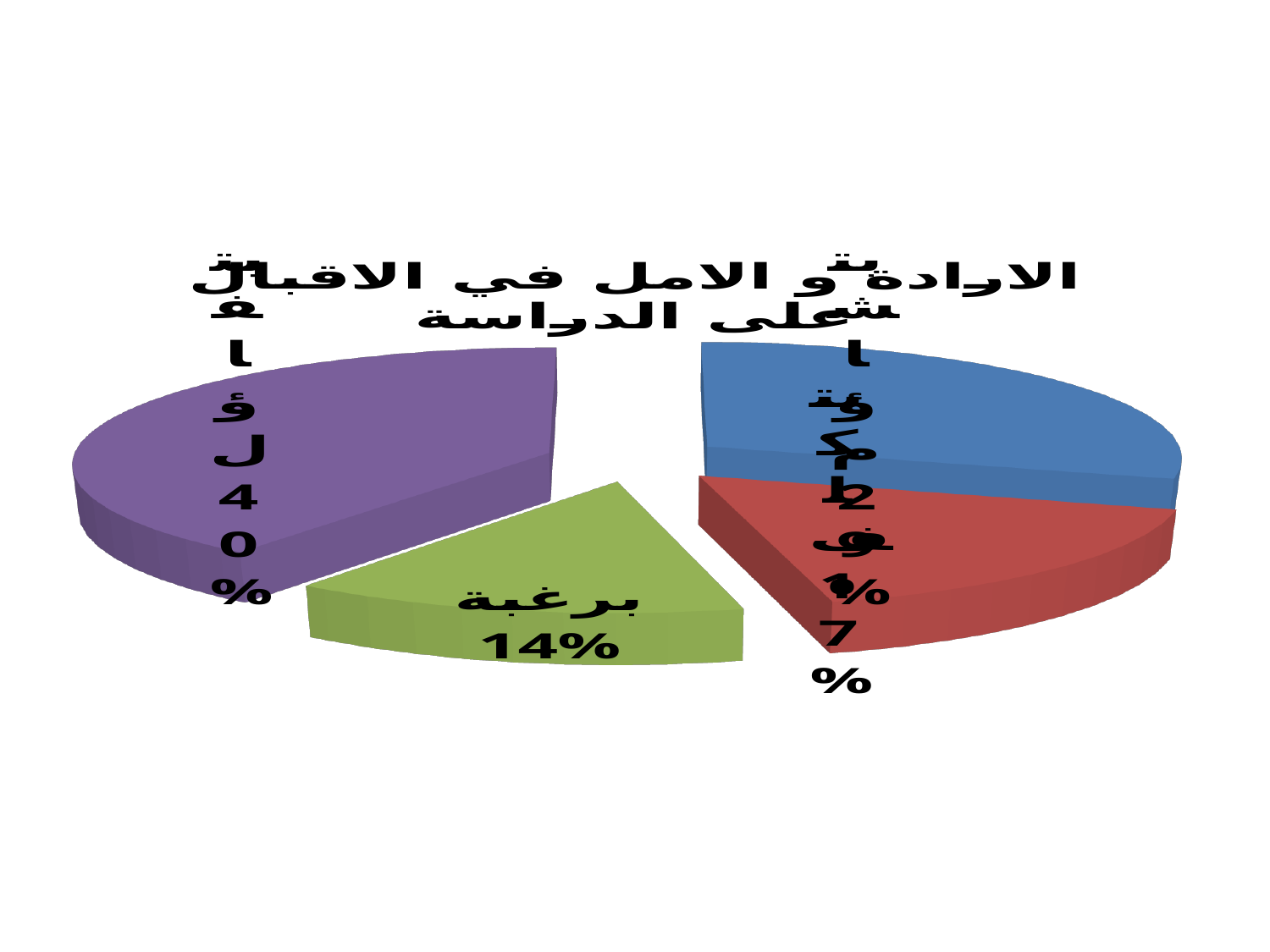
What colour is the برغبة slice? Green Which is larger, the بتفاؤل slice or the برغبة slice? بتفاؤل What is the title of the chart? الارادة و الامل في الاقبال على الدراسة How many slices does the pie chart have? 4 Which slice is the largest in the pie chart? بتفاؤل What percentage is shown for the بتفاؤل slice? 40% What percentage is shown for the برغبة slice? 14% What is the difference in percentage points between the بتفاؤل slice (40%) and the برغبة slice (14%)? 26 percentage points What kind of chart is shown on the slide? Pie chart